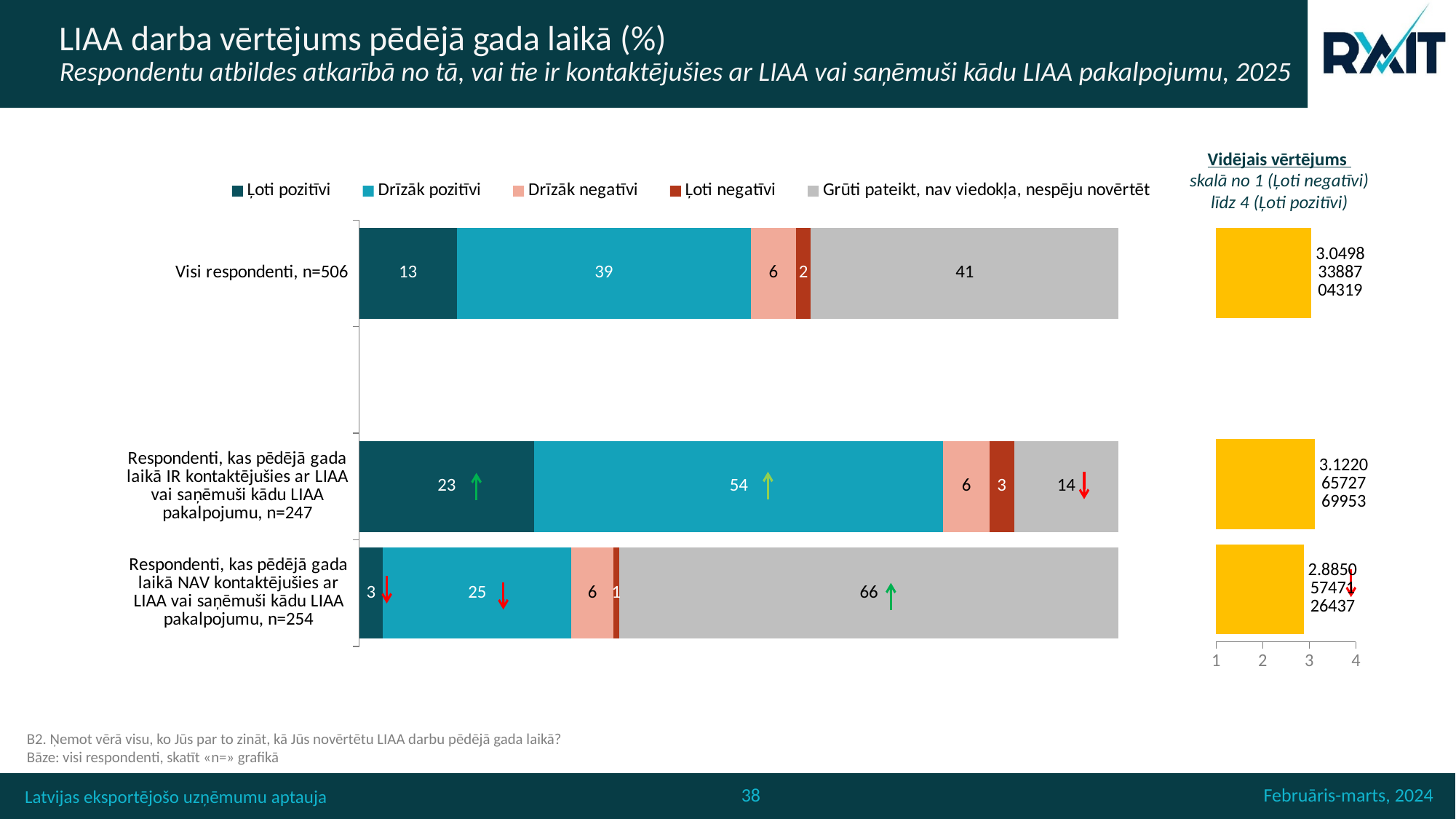
In the stacked bar chart, what is the value for "Ļoti pozitīvi" among respondents who HAVE contacted LIAA (n=247)? 23 In the stacked bar chart, what is the value for "Grūti pateikt, nav viedokļa, nespēju novērtēt" among respondents who have NOT contacted LIAA (n=254)? 66 How many respondent groups (bars) are shown in the stacked bar chart? 3 What kind of chart is the main chart on the slide? Stacked bar chart In the stacked bar chart, what is the value for "Drīzāk pozitīvi" among "Visi respondenti, n=506"? 39 In the stacked bar chart, what is the difference in "Grūti pateikt, nav viedokļa, nespēju novērtēt" between the group that has NOT contacted LIAA (66) and the group that HAS contacted LIAA (14)? 52 In the stacked bar chart, what is the total of the segments for the group that HAS contacted LIAA (n=247)? 100 In the stacked bar chart, which has the larger "Ļoti pozitīvi" value: "Visi respondenti, n=506" or the group that HAS contacted LIAA (n=247)? Respondenti, kas pēdējā gada laikā IR kontaktējušies ar LIAA vai saņēmuši kādu LIAA pakalpojumu, n=247 How many series does the legend of the stacked bar chart list? 5 In the stacked bar chart, which respondent group has the lowest value for "Ļoti pozitīvi"? Respondenti, kas pēdējā gada laikā NAV kontaktējušies ar LIAA vai saņēmuši kādu LIAA pakalpojumu, n=254 In the "Vidējais vērtējums" chart on the right, is the average value for the group that HAS contacted LIAA (n=247) greater or less than 3? greater In the stacked bar chart, which respondent group has the highest value for "Drīzāk pozitīvi"? Respondenti, kas pēdējā gada laikā IR kontaktējušies ar LIAA vai saņēmuši kādu LIAA pakalpojumu, n=247